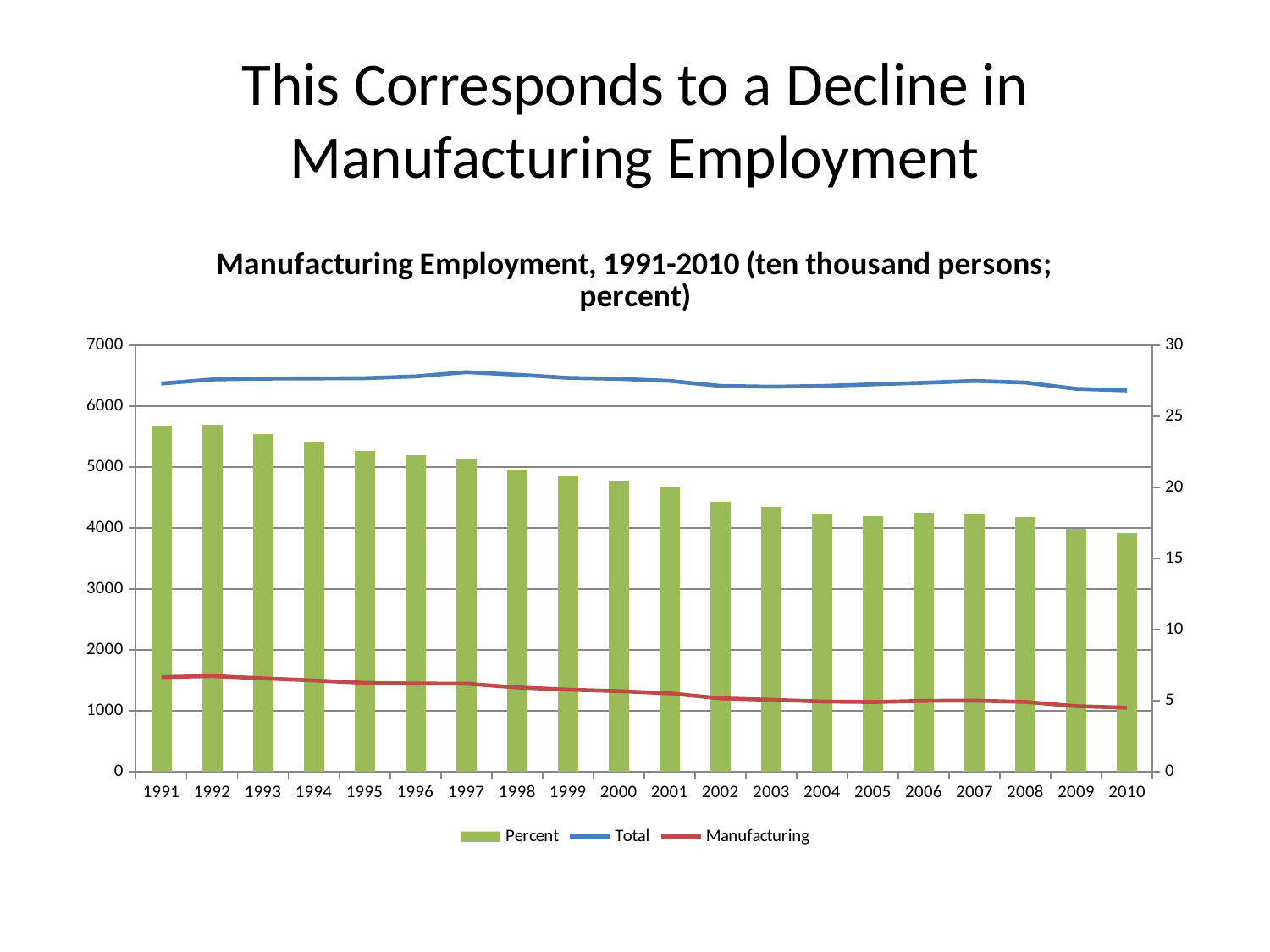
Is the green bar for 2010 greater or less than 5000 on the left axis? less How many series does the chart legend list? 3 Do the green bars generally rise or fall from 1991 to 2010? Fall Is the green bar for 1991 greater or less than 5000 on the left axis? greater Does the Manufacturing line rise or fall from 1991 to 2010? Fall Which year has the taller green bar, 1991 or 2010? 1991 What is the title of the chart? Manufacturing Employment, 1991-2010 (ten thousand persons; percent) Which series are listed in the chart legend? Percent, Total, Manufacturing How many years are shown on the x axis of the chart? 20 Is the Total line in 1997 greater or less than 6000 on the left axis? greater What kind of chart is shown on the slide? Combined bar and line chart Which year has the taller green bar, 1995 or 2005? 1995